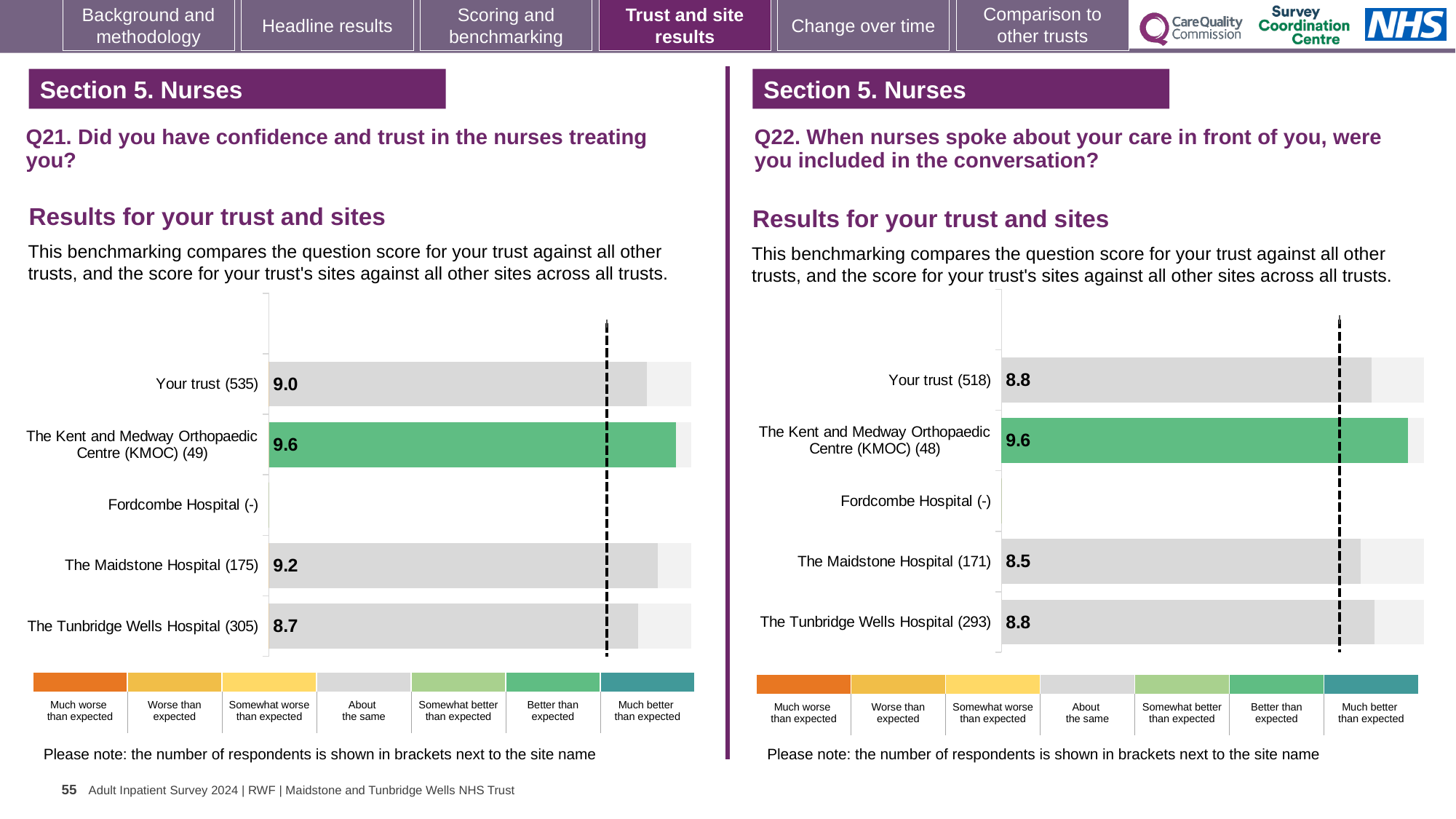
On the Q21 chart (left), how many respondents are shown for The Maidstone Hospital? 175 On the Q22 chart (right), which site has the lowest printed score? The Maidstone Hospital On the Q21 chart (left), what is the difference between the scores for The Kent and Medway Orthopaedic Centre (KMOC) and The Tunbridge Wells Hospital? 0.9 On the Q22 chart (right), which site has no score shown? Fordcombe Hospital On the Q22 chart (right), what is the score for The Kent and Medway Orthopaedic Centre (KMOC)? 9.6 On the Q21 chart (left), what is the score for The Tunbridge Wells Hospital? 8.7 On the Q22 chart (right), what is the difference between the scores for The Kent and Medway Orthopaedic Centre (KMOC) and Your trust? 0.8 On the Q21 chart (left), what is the score for Your trust? 9.0 On the Q22 chart (right), what is the score for The Maidstone Hospital? 8.5 What kind of chart is used on the Q21 chart (left)? Bar chart On the Q21 chart (left), which site has the highest score? The Kent and Medway Orthopaedic Centre (KMOC) On the Q21 chart (left), which has the higher score, The Maidstone Hospital or Your trust? The Maidstone Hospital